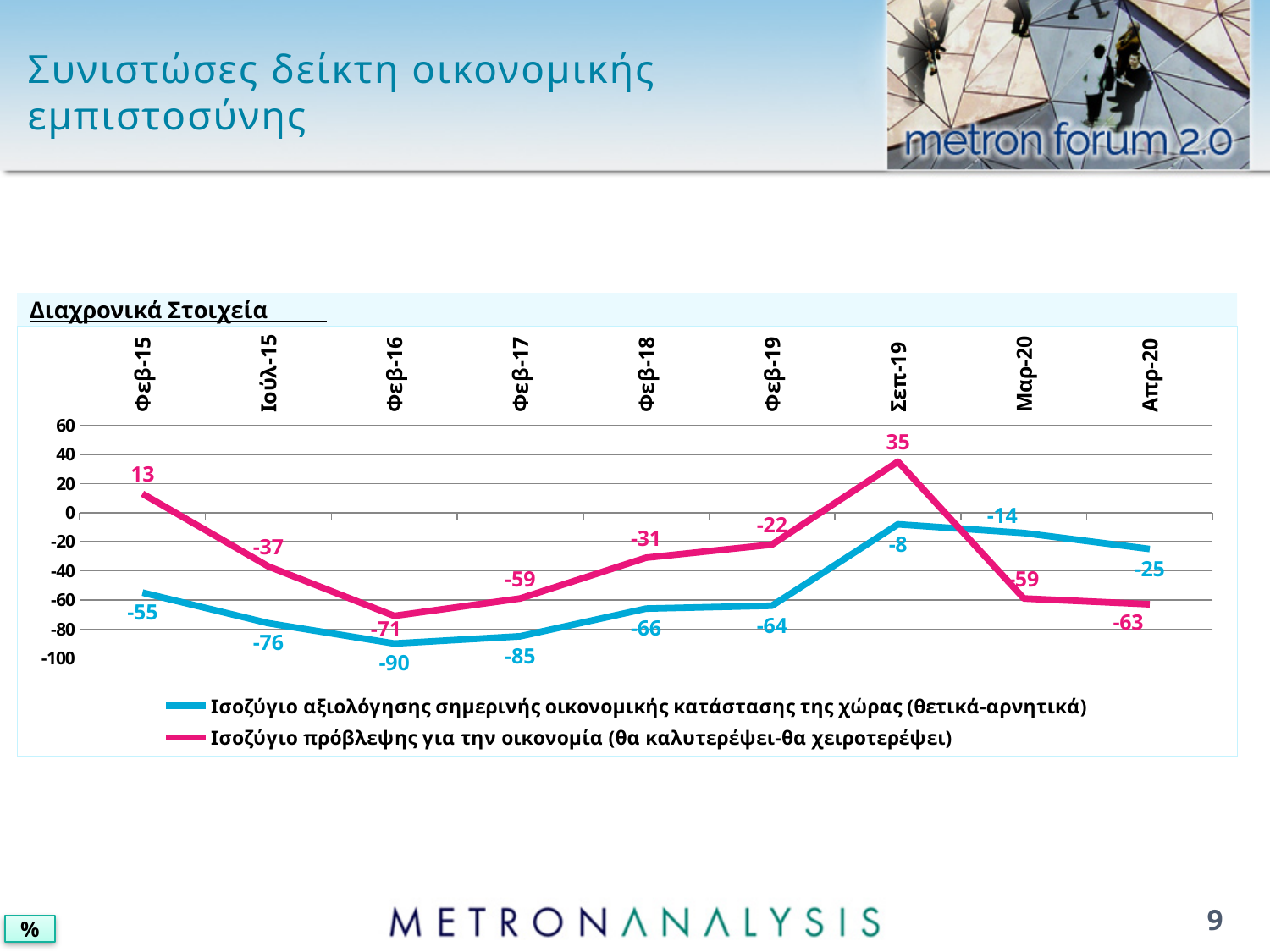
At which time point does the blue series (Ισοζύγιο αξιολόγησης σημερινής οικονομικής κατάστασης) reach its highest value? Σεπ-19 At which time point does the pink series (Ισοζύγιο πρόβλεψης για την οικονομία) reach its lowest value? Φεβ-16 How many time points are shown on the x axis of the chart? 9 What is the difference between the pink series value for Σεπ-19 (35) and its value for Μαρ-20 (-59)? 94 What is the heading shown above the chart? Διαχρονικά Στοιχεία What is the value of the pink series (Ισοζύγιο πρόβλεψης για την οικονομία) for Απρ-20? -63 For Φεβ-15, which series has the higher value: the blue series or the pink series? The pink series (Ισοζύγιο πρόβλεψης για την οικονομία) What is the value of the blue series (Ισοζύγιο αξιολόγησης σημερινής οικονομικής κατάστασης της χώρας) for Φεβ-16? -90 What is the value of the pink series (Ισοζύγιο πρόβλεψης για την οικονομία) for Σεπ-19? 35 How many series does the chart legend list? 2 What type of chart is shown on the slide? Line chart Does the blue series rise or fall between Φεβ-19 and Σεπ-19? Rise